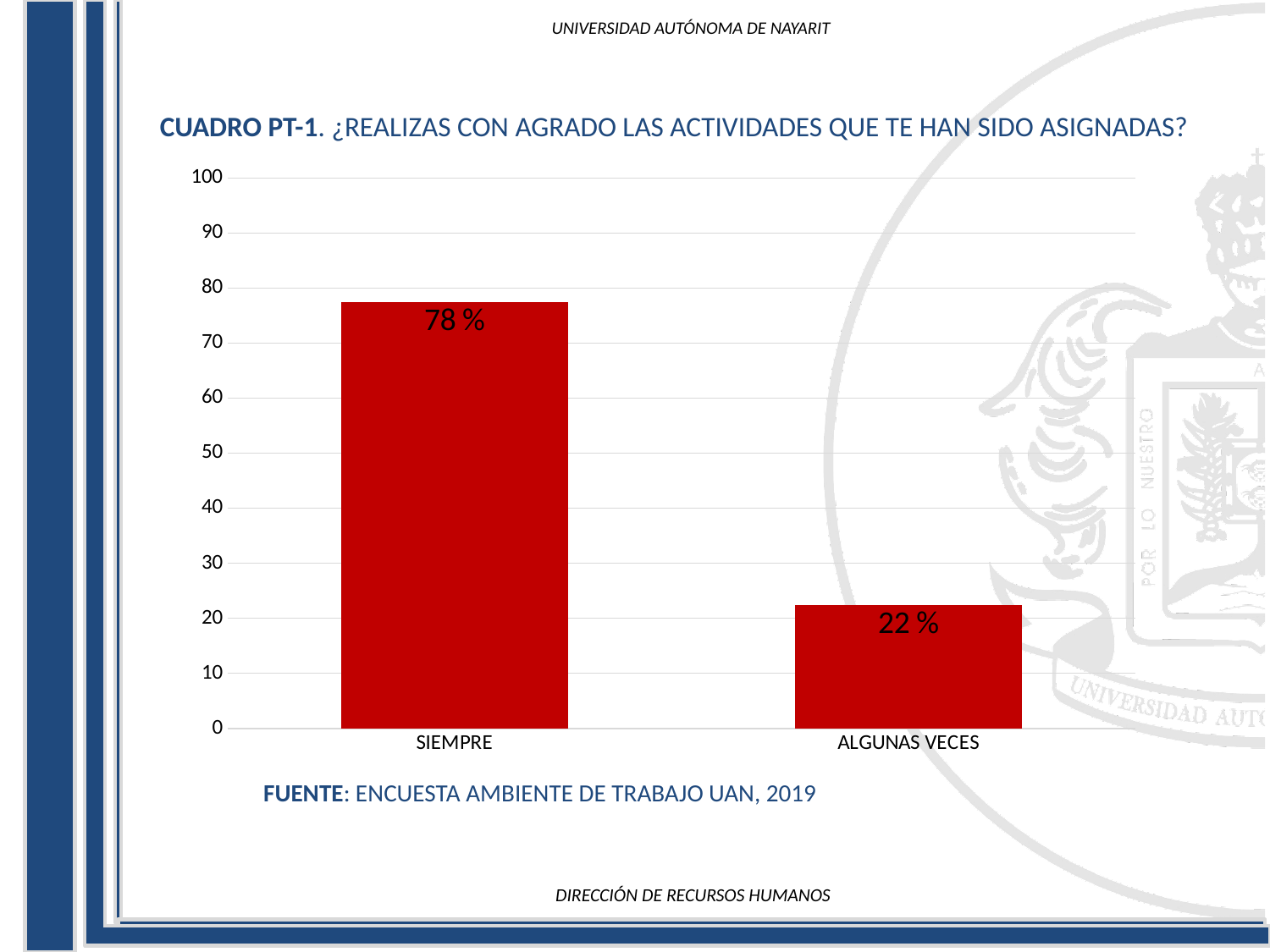
What is the value for ALGUNAS VECES? 22 % Which is larger, the value for SIEMPRE or the value for ALGUNAS VECES? SIEMPRE How many categories are shown in the chart? 2 What is the value for SIEMPRE? 78 % What kind of chart is shown on the slide? bar chart Which category has the highest value? SIEMPRE What colour are the bars in the chart? red What is the difference between the values for SIEMPRE and ALGUNAS VECES? 56 % Is the value for SIEMPRE greater or less than 70? greater Is the value for ALGUNAS VECES greater or less than 30? less What is the source cited below the chart? ENCUESTA AMBIENTE DE TRABAJO UAN, 2019 Which category has the lowest value? ALGUNAS VECES